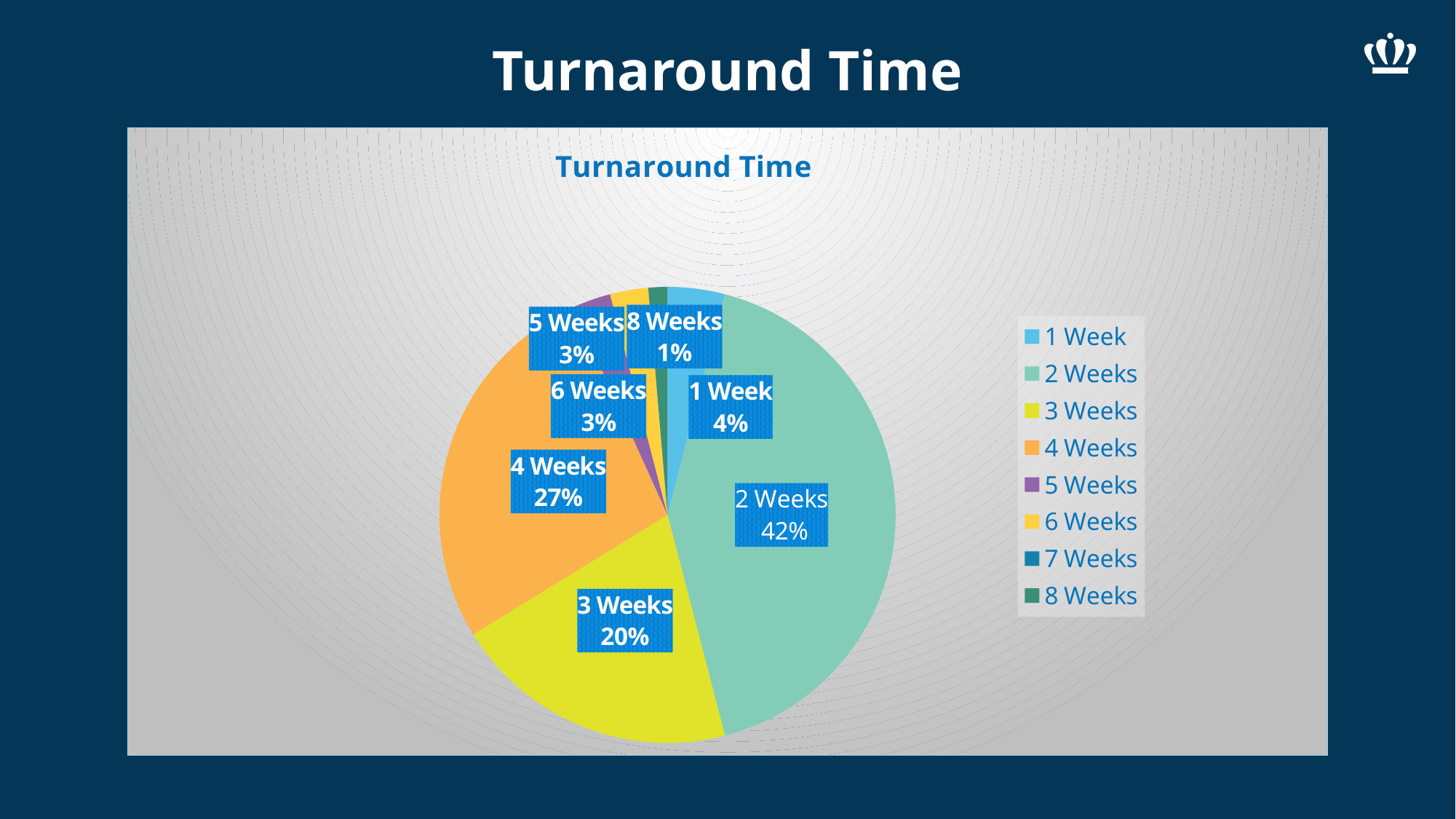
What is the difference between the 2 Weeks and 4 Weeks shares? 15% What is the title of the chart? Turnaround Time What is the value shown for 5 Weeks? 3% Which category has the largest slice of the pie? 2 Weeks How many entries does the legend list? 8 What share of the pie does the 2 Weeks slice represent? 42% What is the value shown for 3 Weeks? 20% What is the value shown for 4 Weeks? 27% What is the value shown for 1 Week? 4% What is the value shown for 8 Weeks? 1% Which is larger, the 3 Weeks slice or the 4 Weeks slice? 4 Weeks What kind of chart is shown on the slide? Pie chart